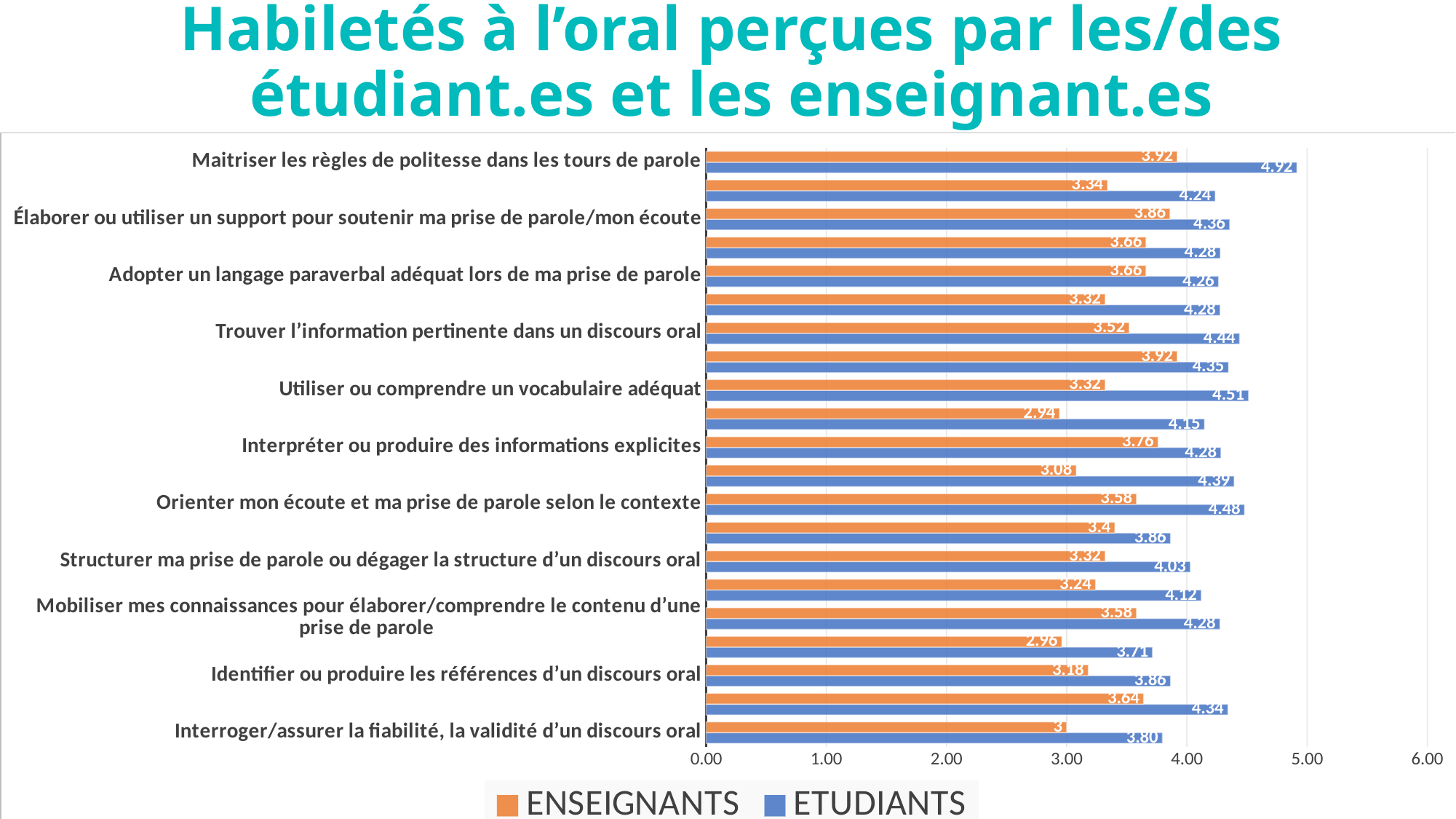
What is the difference between the ETUDIANTS and ENSEIGNANTS values for "Maitriser les règles de politesse dans les tours de parole"? 1.00 What is the ENSEIGNANTS value for "Utiliser ou comprendre un vocabulaire adéquat"? 3.32 What is the ETUDIANTS value for "Maitriser les règles de politesse dans les tours de parole"? 4.92 How many series does the legend list? 2 What is the ENSEIGNANTS value for "Orienter mon écoute et ma prise de parole selon le contexte"? 3.58 Is the ENSEIGNANTS value for "Interroger/assurer la fiabilité, la validité d'un discours oral" greater or less than 4.00? less Which colour represents the ENSEIGNANTS series in the legend? Orange Which category has the highest ETUDIANTS value? Maitriser les règles de politesse dans les tours de parole What is the difference between the ETUDIANTS and ENSEIGNANTS values for "Utiliser ou comprendre un vocabulaire adéquat"? 1.19 For "Identifier ou produire les références d'un discours oral", which series has the larger value, ENSEIGNANTS or ETUDIANTS? ETUDIANTS What kind of chart is shown on the slide? Bar chart What is the ETUDIANTS value for "Interroger/assurer la fiabilité, la validité d'un discours oral"? 3.80